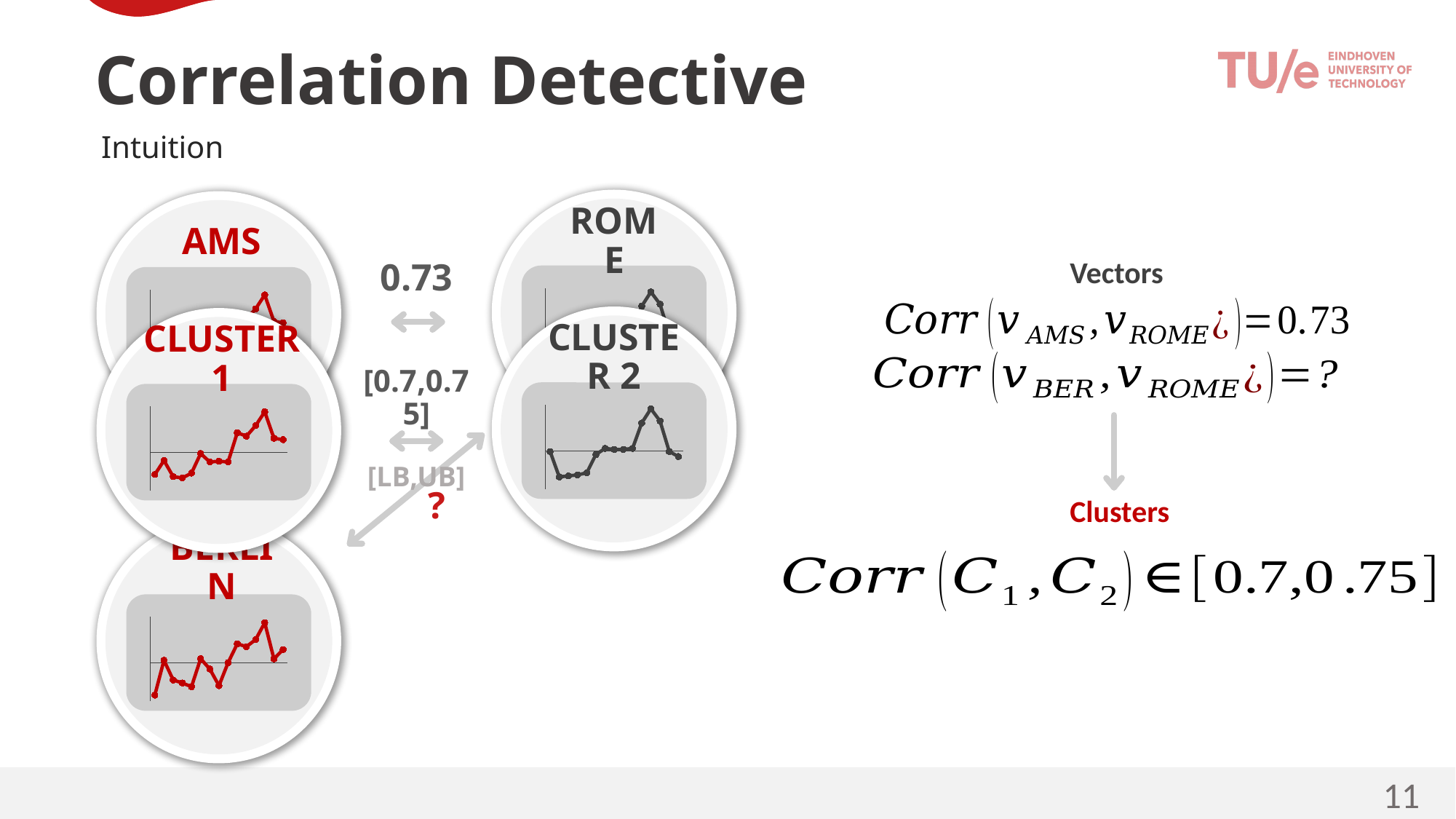
What correlation value is printed between the AMS chart and the ROME chart? 0.73 What colour is the line in the CLUSTER 1 chart? red What kind of chart is shown inside the CLUSTER 1 circle? line chart In the CLUSTER 1 chart, do the values generally rise or fall from left to right? rise What kind of chart is shown inside the CLUSTER 2 circle? line chart How many small line charts are visible on the slide? 5